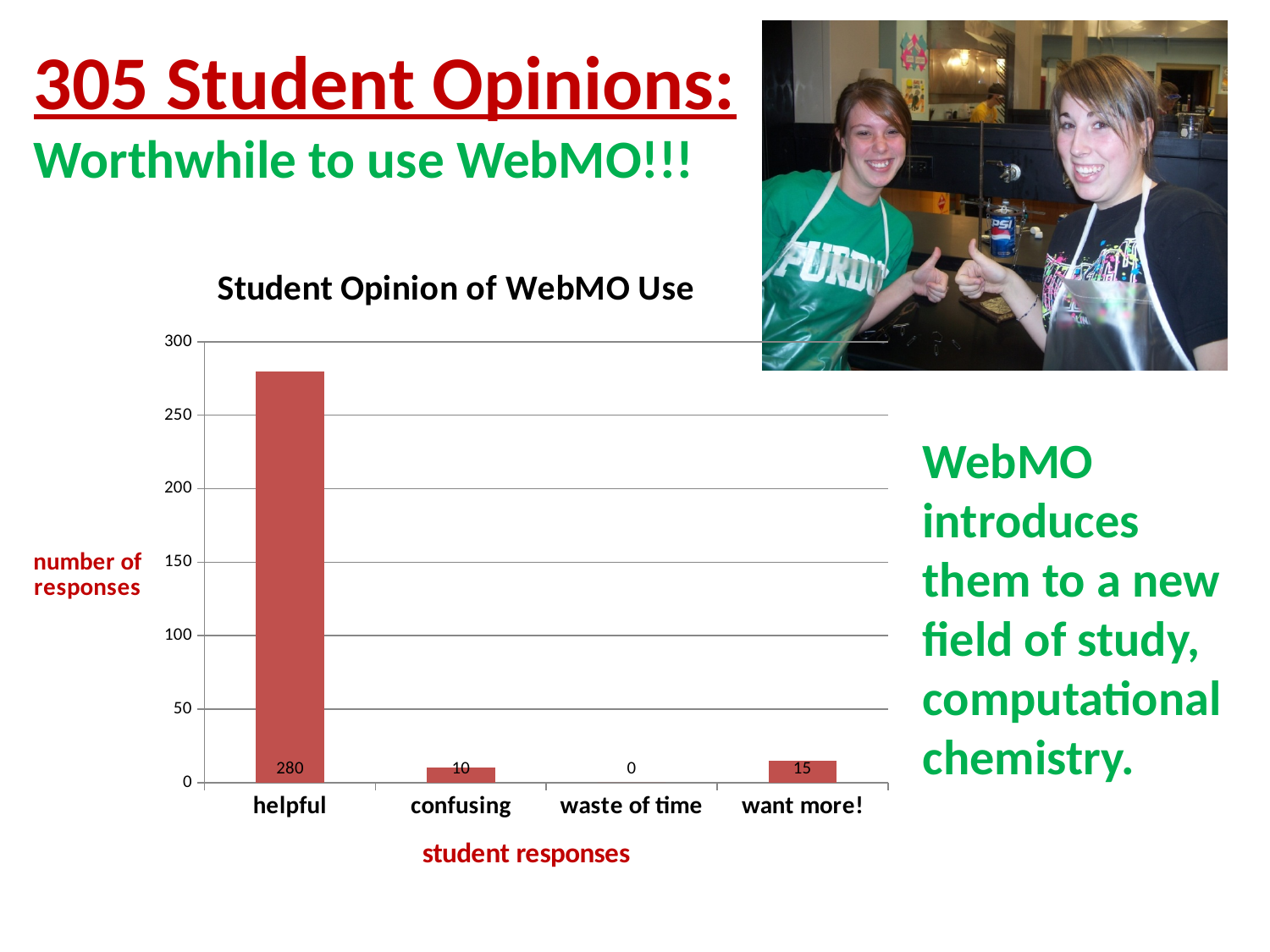
What is the number of responses for "helpful"? 280 How many student response categories are shown on the x axis? 4 Which student response category has the highest number of responses? helpful What is the number of responses for "waste of time"? 0 What is the title of the chart? Student Opinion of WebMO Use Which has more responses, "confusing" or "want more!"? want more! Is the value for "helpful" greater or less than 250? greater What kind of chart is shown on the slide? bar chart What is the difference in number of responses between "helpful" and "want more!"? 265 What is the number of responses for "confusing"? 10 What is the number of responses for "want more!"? 15 Which student response category has the lowest number of responses? waste of time